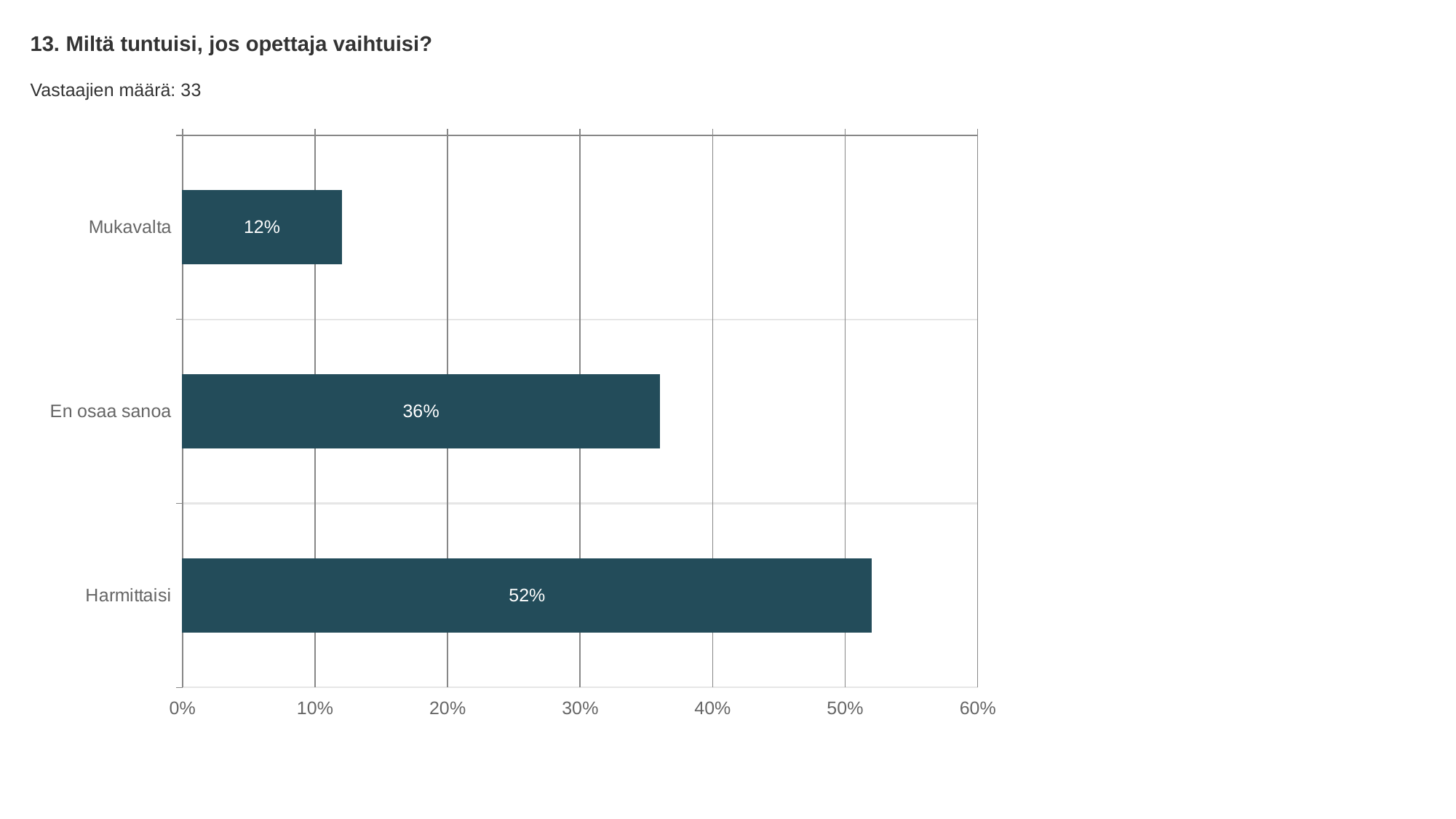
How many respondents (Vastaajien määrä) does the slide report? 33 What is the value for Harmittaisi? 52% What kind of chart is shown on the slide? bar chart Which is larger, the value for En osaa sanoa or the value for Mukavalta? En osaa sanoa What is the value for Mukavalta? 12% What is the difference between the values for Harmittaisi and En osaa sanoa? 16% What is the value for En osaa sanoa? 36% Which category has the highest value? Harmittaisi Which category has the lowest value? Mukavalta How many categories are shown in the chart? 3 Is the value for Harmittaisi greater or less than 50%? greater What is the difference between the values for En osaa sanoa and Mukavalta? 24%